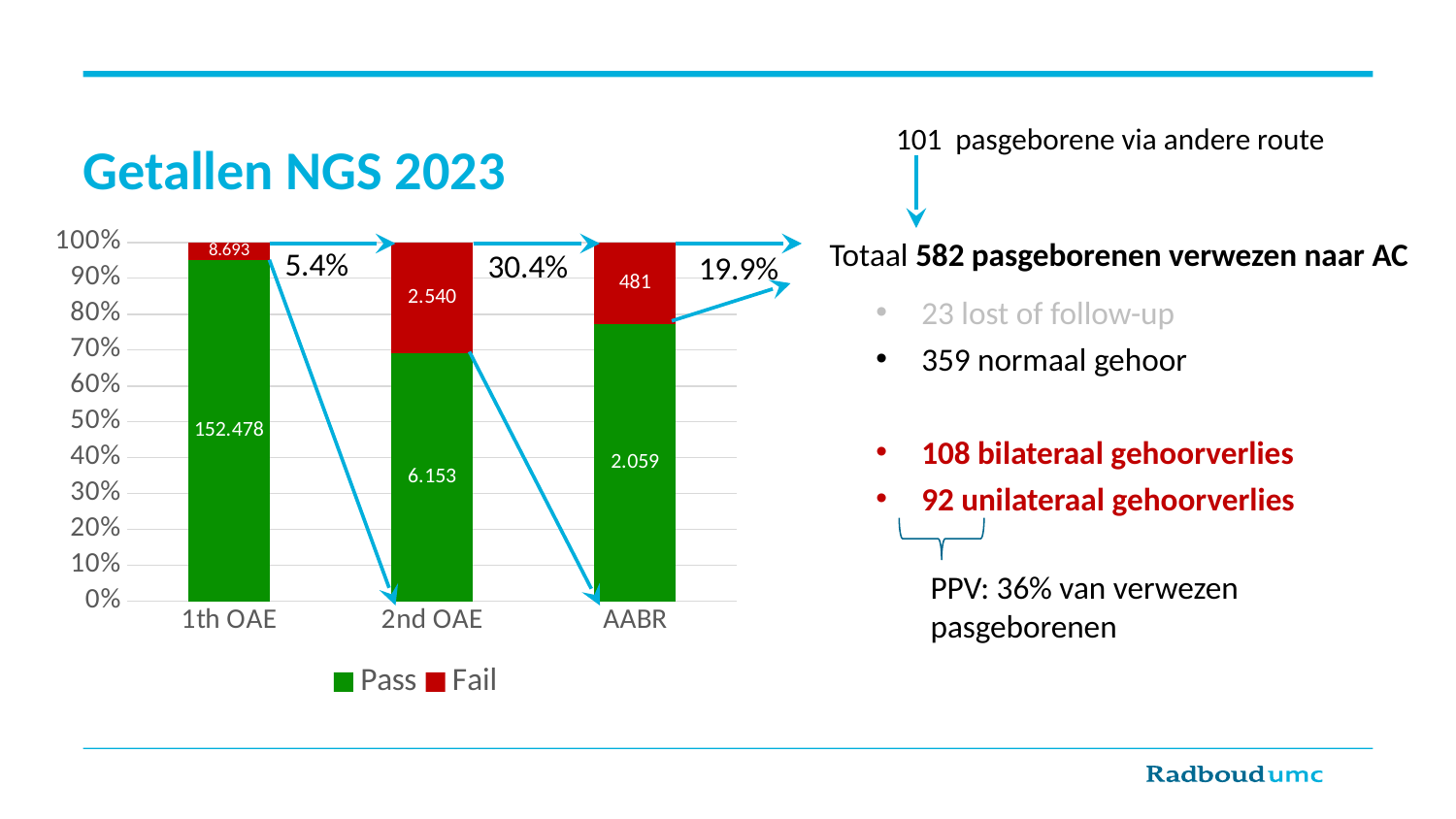
What is the Pass value for AABR? 2.059 How many categories are shown on the x axis? 3 Which category has the lowest Fail value? AABR How many series does the legend list? 2 What is the total of the stacked bar for AABR? 2.540 What is the Fail value for AABR? 481 What kind of chart is shown on the slide? Stacked bar chart What is the difference between the Pass and Fail values for 2nd OAE? 3.613 What is the Fail value for 2nd OAE? 2.540 What is the Pass value for 1th OAE? 152.478 Which category has the highest Pass value? 1th OAE Is the Pass share of the 2nd OAE bar greater or less than 60%? greater